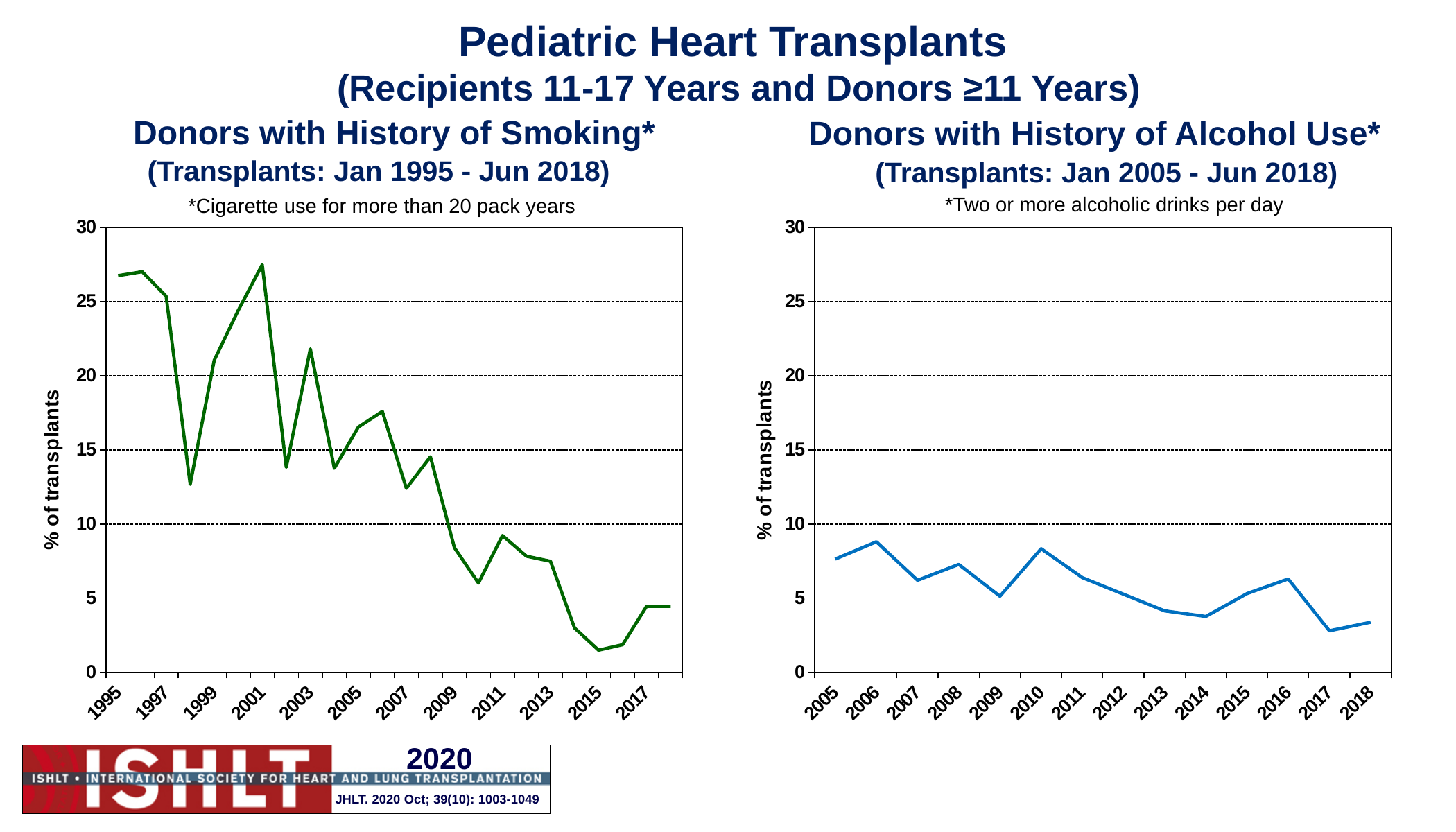
In the 'Donors with History of Smoking*' chart, is the value for 2015 greater or less than 5? less In the 'Donors with History of Smoking*' chart, do the values generally rise or fall from 1995 to 2018? fall In the 'Donors with History of Alcohol Use*' chart on the right, how many years are labeled on the x axis? 14 What is the y-axis label on the 'Donors with History of Smoking*' chart? % of transplants In the 'Donors with History of Alcohol Use*' chart, is the value for 2017 greater or less than 5? less In the 'Donors with History of Smoking*' chart, which year has the lowest value? 2015 In the 'Donors with History of Alcohol Use*' chart, which is larger, the value for 2006 or the value for 2009? 2006 What kind of chart is the 'Donors with History of Smoking*' chart on the left? line chart In the 'Donors with History of Alcohol Use*' chart, do the values generally rise or fall from 2005 to 2018? fall In the 'Donors with History of Alcohol Use*' chart, which year has the lowest value? 2017 In the 'Donors with History of Smoking*' chart, is the value for 1995 greater or less than 25? greater